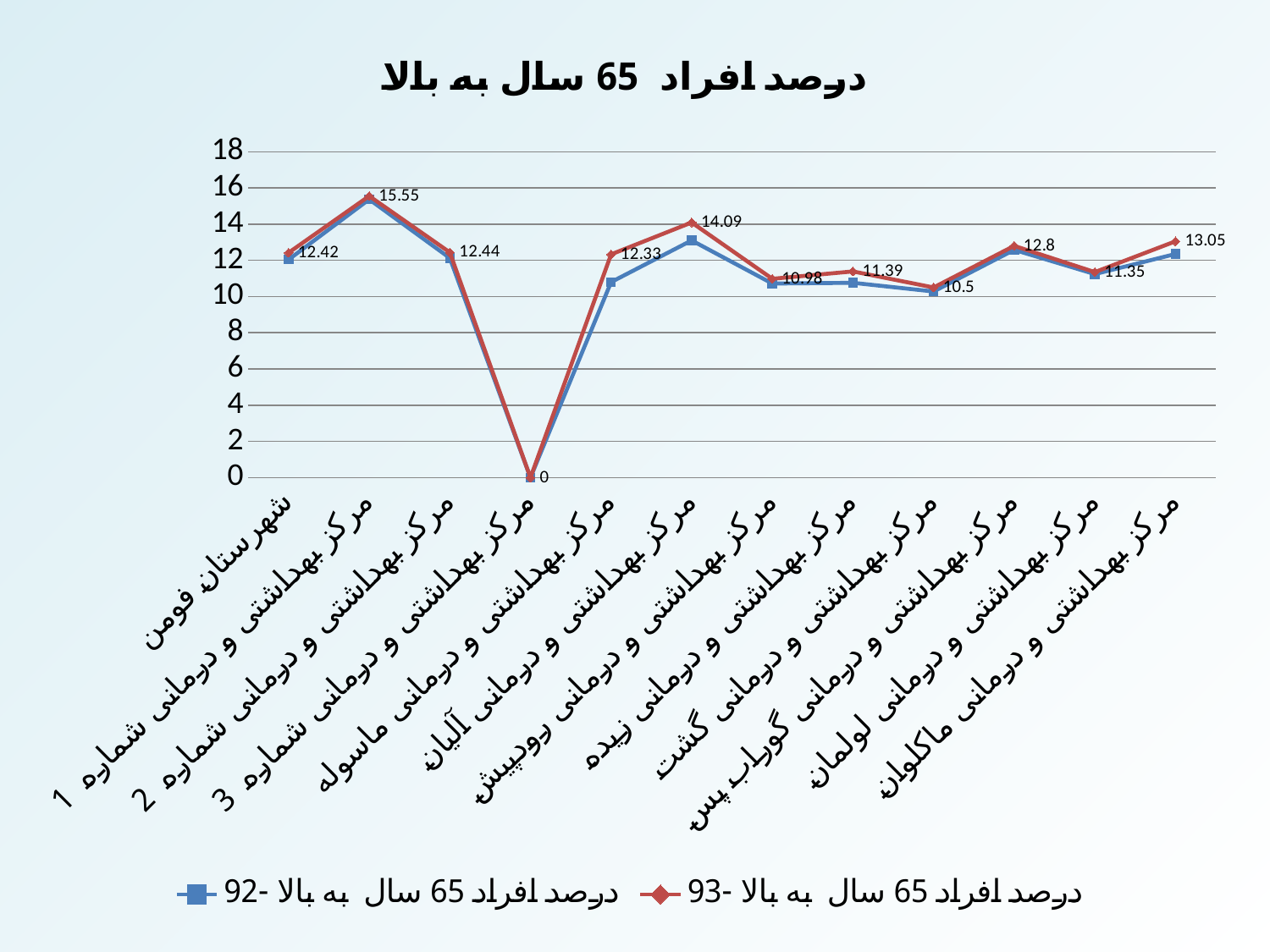
Which category has the highest value in the 93 series? مرکز بهداشتی و درمانی شماره 1 What is the value of the 93 series for مرکز بهداشتی و درمانی گشت? 10.5 How many series does the legend list? 2 In the 93 series, which is larger: the value for مرکز بهداشتی و درمانی رودپیش or the value for مرکز بهداشتی و درمانی آلیان? مرکز بهداشتی و درمانی آلیان How many categories are plotted along the x axis? 12 In the 93 series, what is the difference between the value for مرکز بهداشتی و درمانی شماره 1 and the value for شهرستان فومن? 3.13 Is the value of the 92 series (درصد افراد 65 سال به بالا -92) for مرکز بهداشتی و درمانی آلیان greater or less than 12? greater What kind of chart is shown on the slide? line chart What is the title of the chart? درصد افراد 65 سال به بالا What is the value of the 93 series (درصد افراد 65 سال به بالا -93) for مرکز بهداشتی و درمانی شماره 1? 15.55 What is the value of the 93 series for مرکز بهداشتی و درمانی ماکلوان? 13.05 Which category has the lowest value in the 93 series? مرکز بهداشتی و درمانی شماره 3